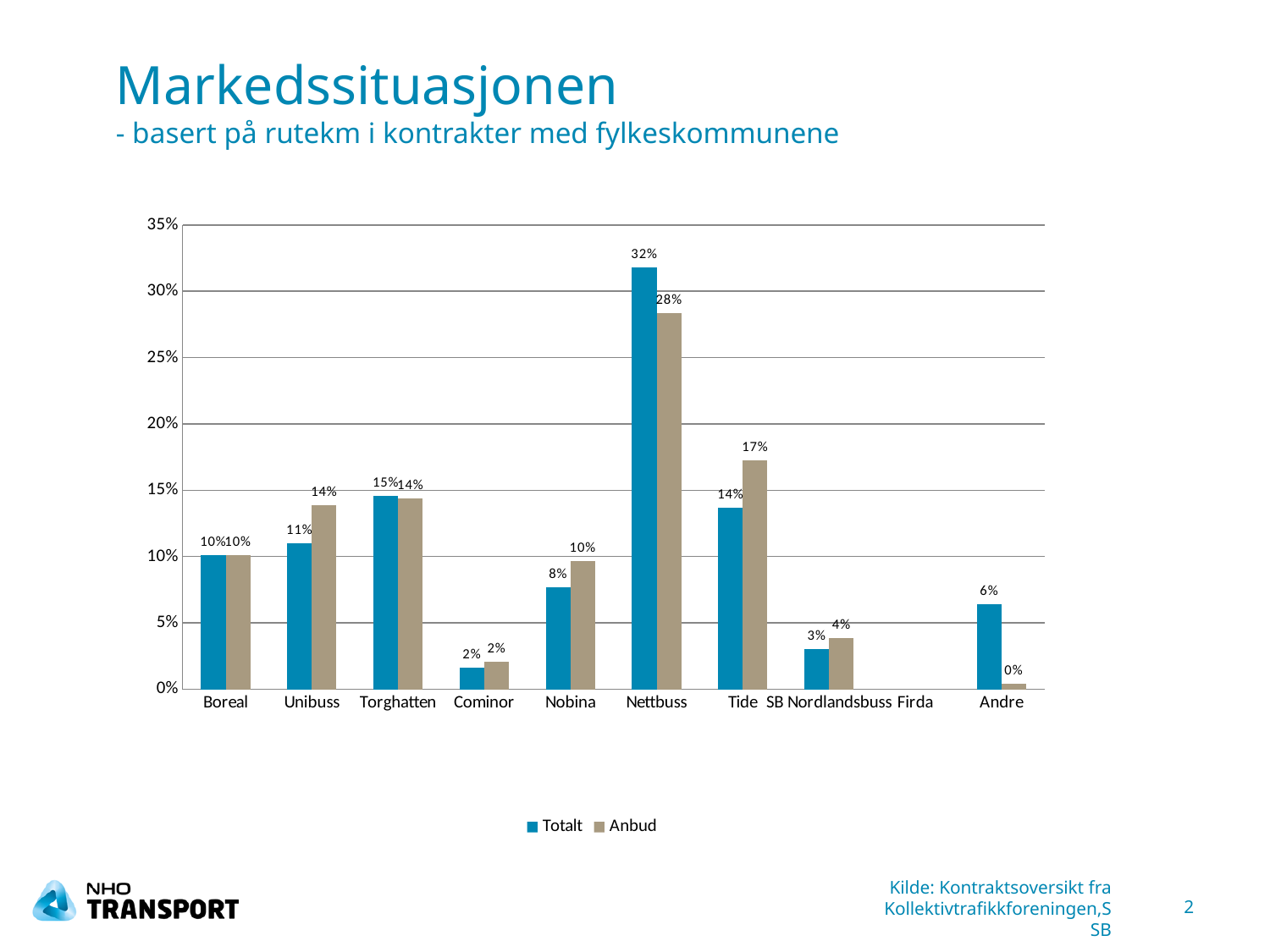
What are the two series named in the legend? Totalt and Anbud Which category has the highest Totalt value? Nettbuss What is the Anbud value for Tide? 17% What is the Anbud value for Nobina? 10% For Unibuss, which is larger: the Totalt value or the Anbud value? Anbud Which category has the lowest Anbud value? Andre What is the Totalt value for Nettbuss? 32% Is the Anbud value for Nettbuss greater or less than 25%? greater What is the difference between the Totalt and Anbud values for Nettbuss? 4 percentage points What kind of chart is shown on the slide? bar chart How many series does the legend list? 2 How many categories are shown on the x axis? 10